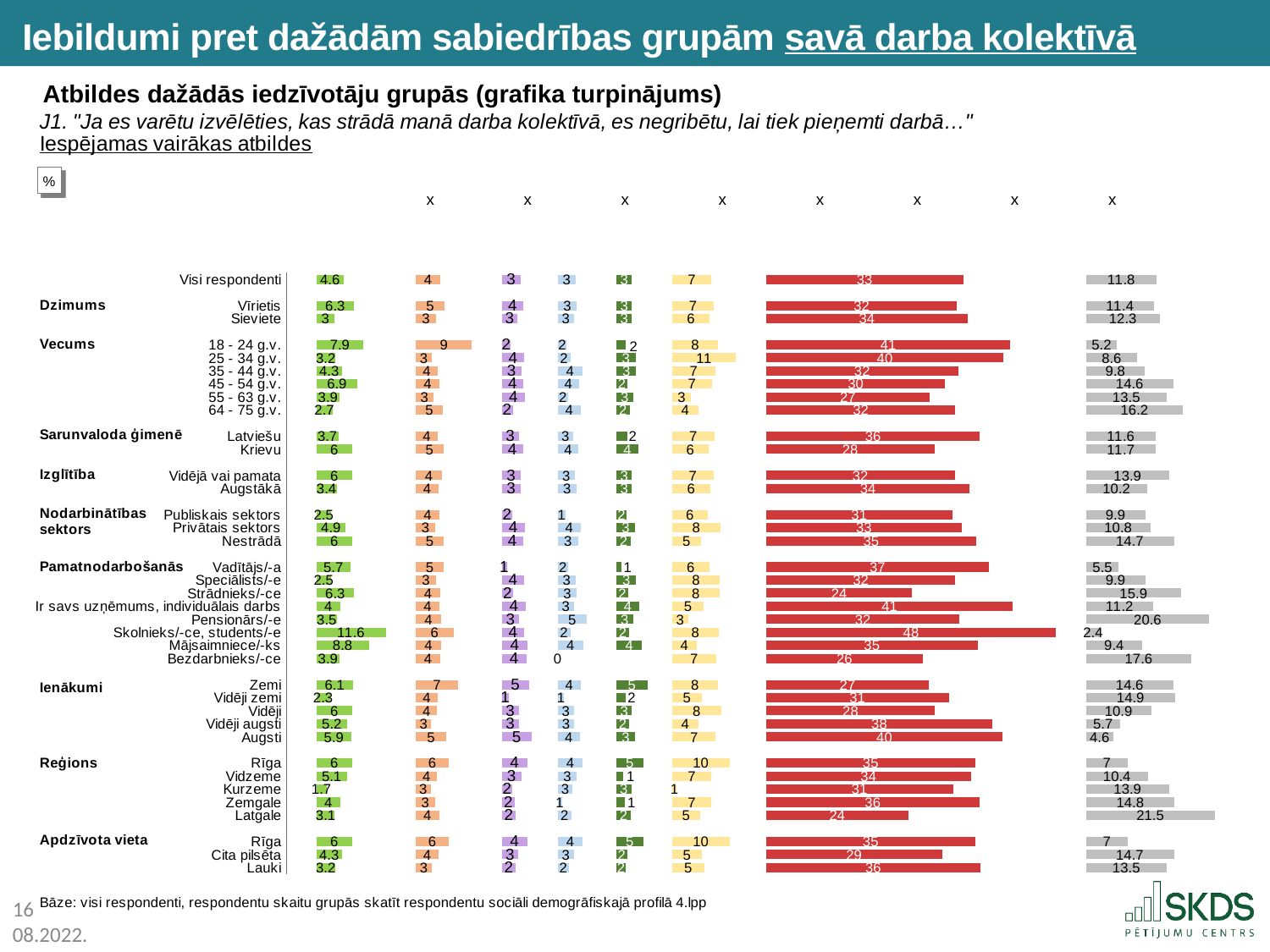
In the red (seventh) column, what is the difference between the values for Sieviete and Vīrietis? 2 What kind of chart is shown on the slide? Bar chart In the green (first) column, which is larger: the value for 18 - 24 g.v. or for 64 - 75 g.v.? 18 - 24 g.v. In the red (seventh) column, which is larger: the value for Latviešu or for Krievu? Latviešu How many bar columns (series) does the chart show? 8 In the grey (last) column, which category has the lowest value? Skolnieks/-ce, students/-e In the grey (last) column, what is the value for Pensionārs/-e? 20.6 In the red (seventh) column, what is the value for Visi respondenti? 33 In the red (seventh) column, which category has the highest value? Skolnieks/-ce, students/-e In the green (first) column, what is the value for Skolnieks/-ce, students/-e? 11.6 In the grey (last) column, what is the difference between the values for Latgale and Rīga (Reģions)? 14.5 In the grey (last) column, what is the value for Latgale? 21.5